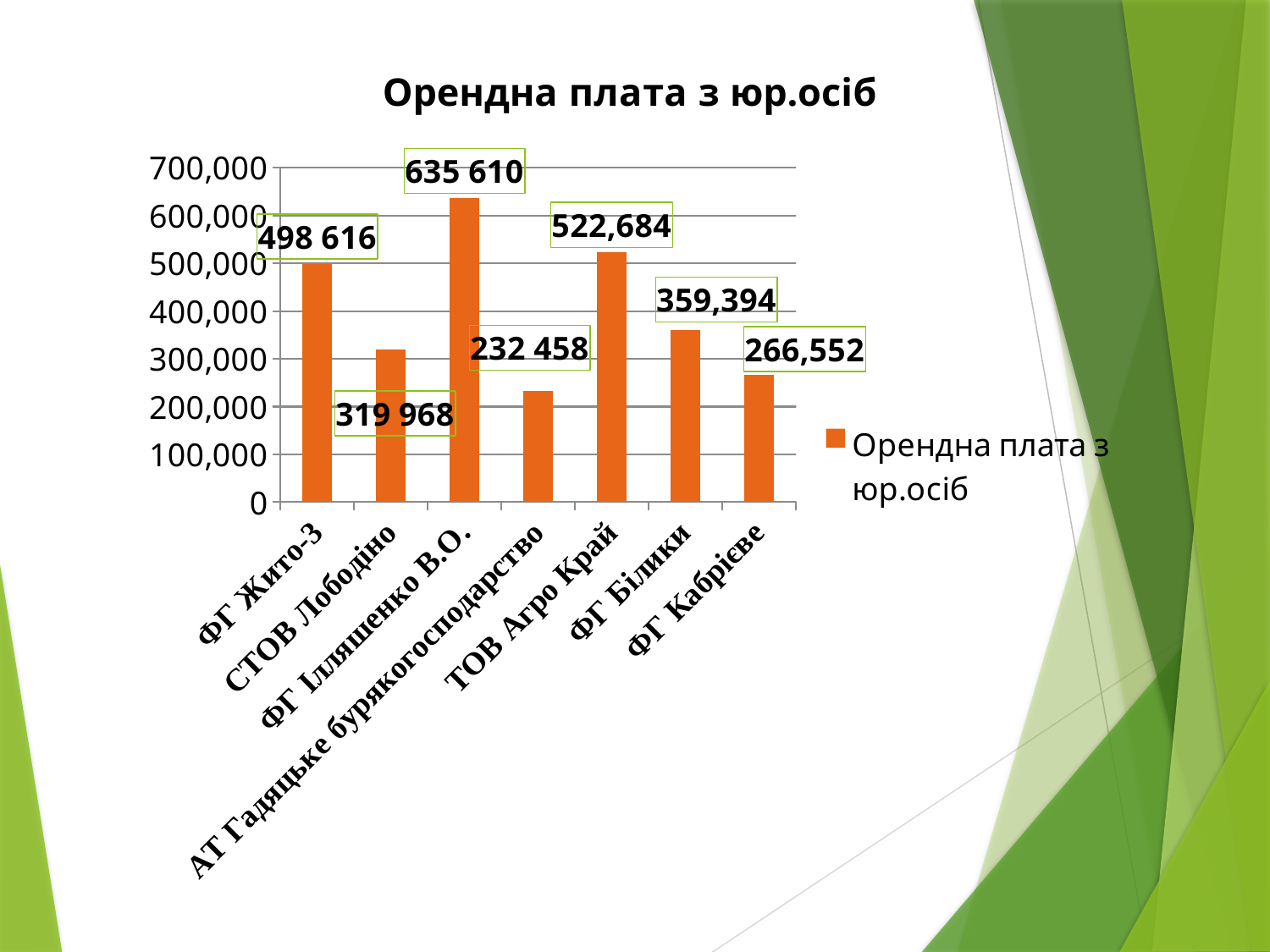
What is the value for ФГ Кабрієве? 266,552 What is the difference between the values for ТОВ Агро Край and ФГ Білики? 163,290 How many categories are shown on the x axis? 7 What is the title of the chart? Орендна плата з юр.осіб What is the value for ТОВ Агро Край? 522,684 What kind of chart is this? Bar chart Which is larger, the value for ФГ Білики or the value for ФГ Кабрієве? ФГ Білики Which category has the lowest value? АТ Гадяцьке бурякогосподарство What is the value for ФГ Жито-3? 498 616 What is the value for АТ Гадяцьке бурякогосподарство? 232 458 Which category has the highest value? ФГ Ілляшенко В.О. What is the difference between the values for ФГ Жито-3 and СТОВ Лободіно? 178 648